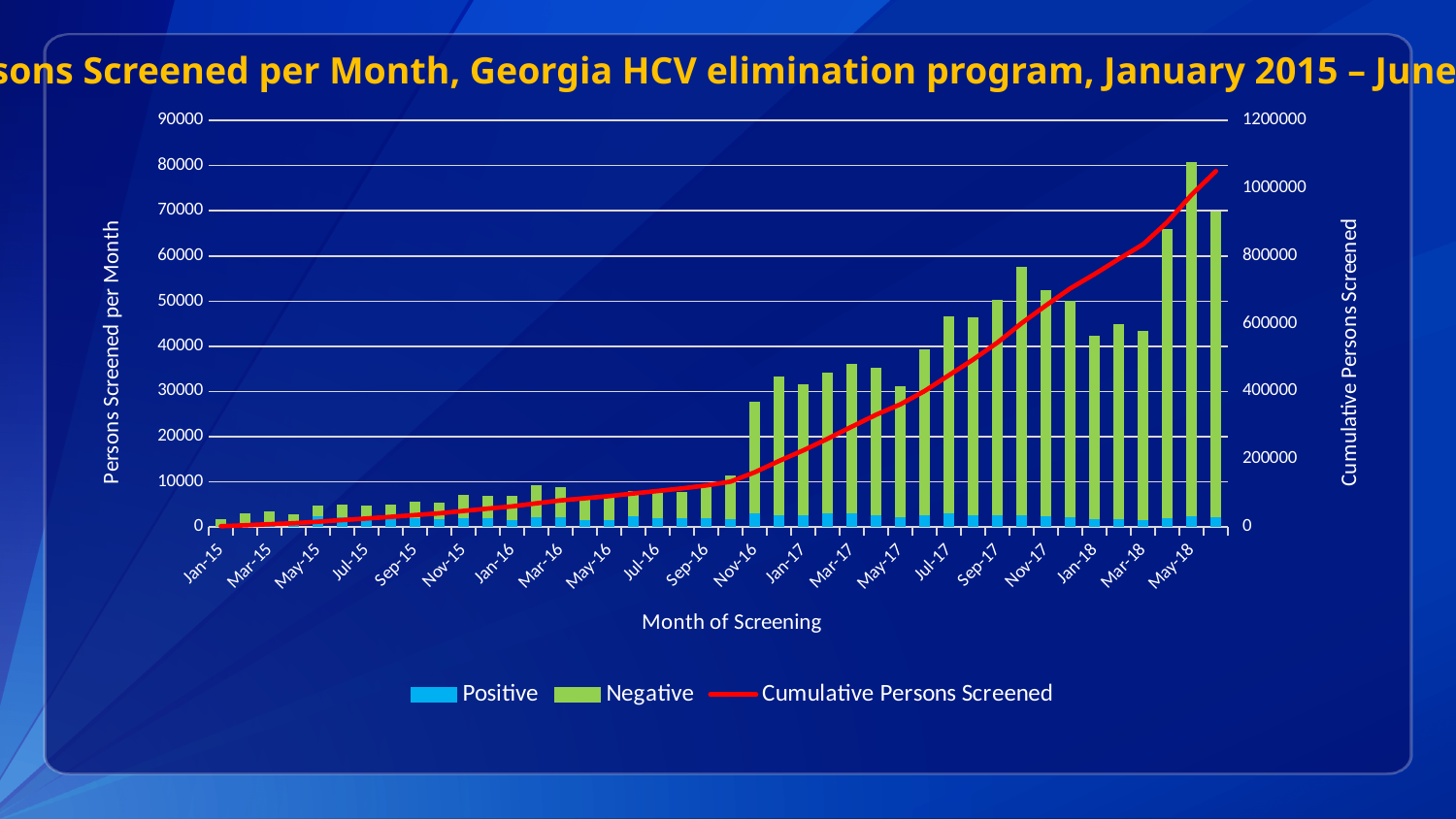
What kind of chart is this? A stacked bar chart combined with a line What is the title of the x axis? Month of Screening Which month has the tallest bar for persons screened per month? May-18 Which month has the taller bar, Nov-17 or Jan-18? Nov-17 Is the total bar for Jan-15 greater or less than 10000 persons screened per month? less Does the Cumulative Persons Screened line rise or fall from Jan-15 to the end of the x axis? Rises Is the total bar for May-18 greater or less than 70000 persons screened per month? greater Is the Cumulative Persons Screened value at Jan-16 greater or less than 200000? less Which month has the taller bar, Nov-16 or Jan-17? Jan-17 What is the highest tick value shown on the right-hand (Cumulative Persons Screened) axis? 1200000 What colour represents the Negative series in the legend? Green How many series does the legend list? 3